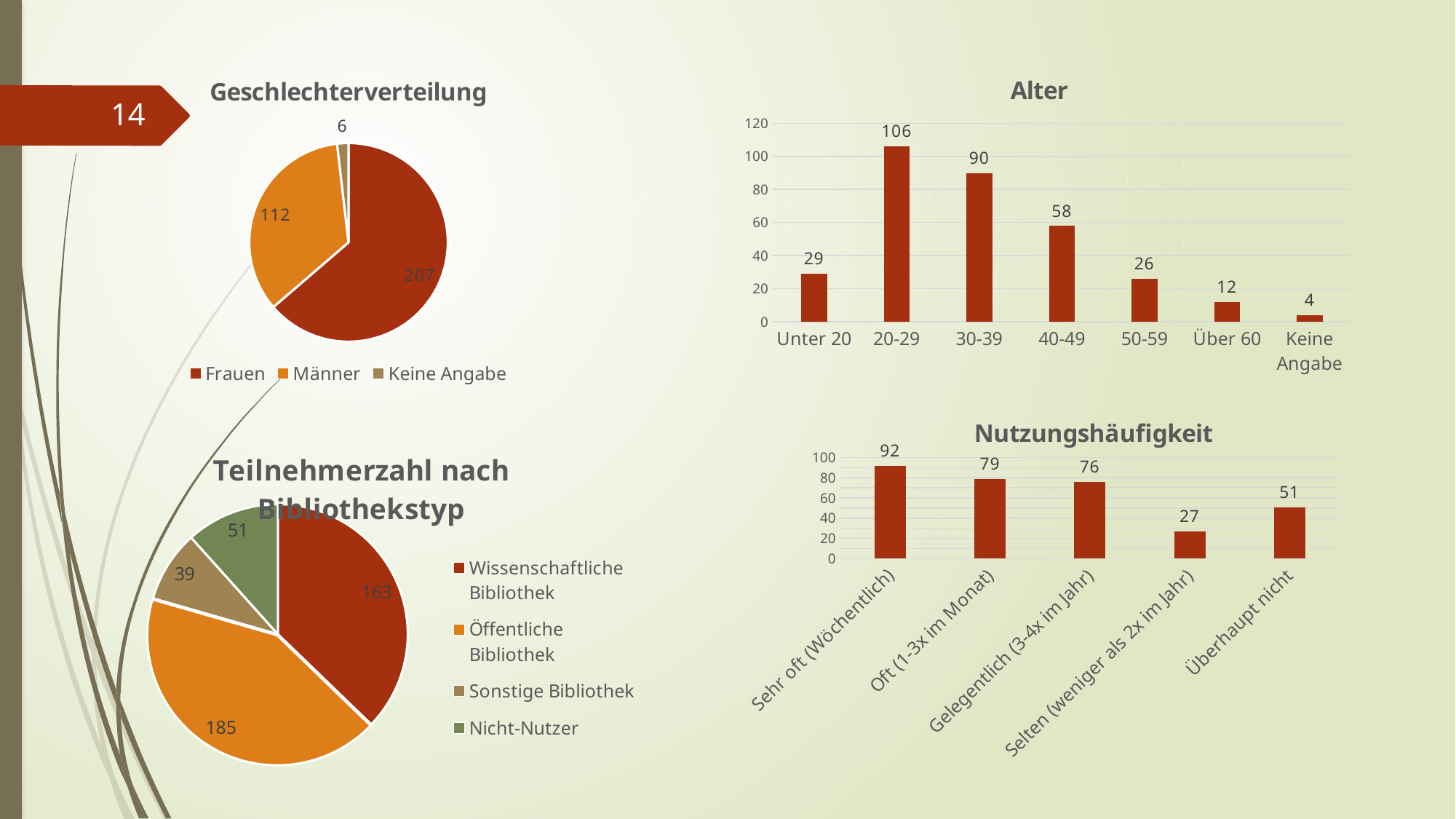
In the 'Alter' chart, what is the value for 40-49? 58 In the 'Alter' chart, which age group has the highest value? 20-29 In the 'Teilnehmerzahl nach Bibliothekstyp' chart, which category has the largest slice? Öffentliche Bibliothek In the 'Alter' chart, what is the difference between the 20-29 and 30-39 groups? 16 In the 'Teilnehmerzahl nach Bibliothekstyp' chart, what is the total of all slices? 438 In the 'Geschlechterverteilung' chart, what is the value for Frauen? 207 In the 'Alter' chart, how many categories are shown on the x axis? 7 In the 'Teilnehmerzahl nach Bibliothekstyp' chart, what is the value for Nicht-Nutzer? 51 In the 'Geschlechterverteilung' chart, what is the value for Männer? 112 What kind of chart is 'Nutzungshäufigkeit'? Bar chart In the 'Nutzungshäufigkeit' chart, which category has the lowest value? Selten (weniger als 2x im Jahr) In the 'Geschlechterverteilung' chart, what is the difference between Frauen and Männer? 95